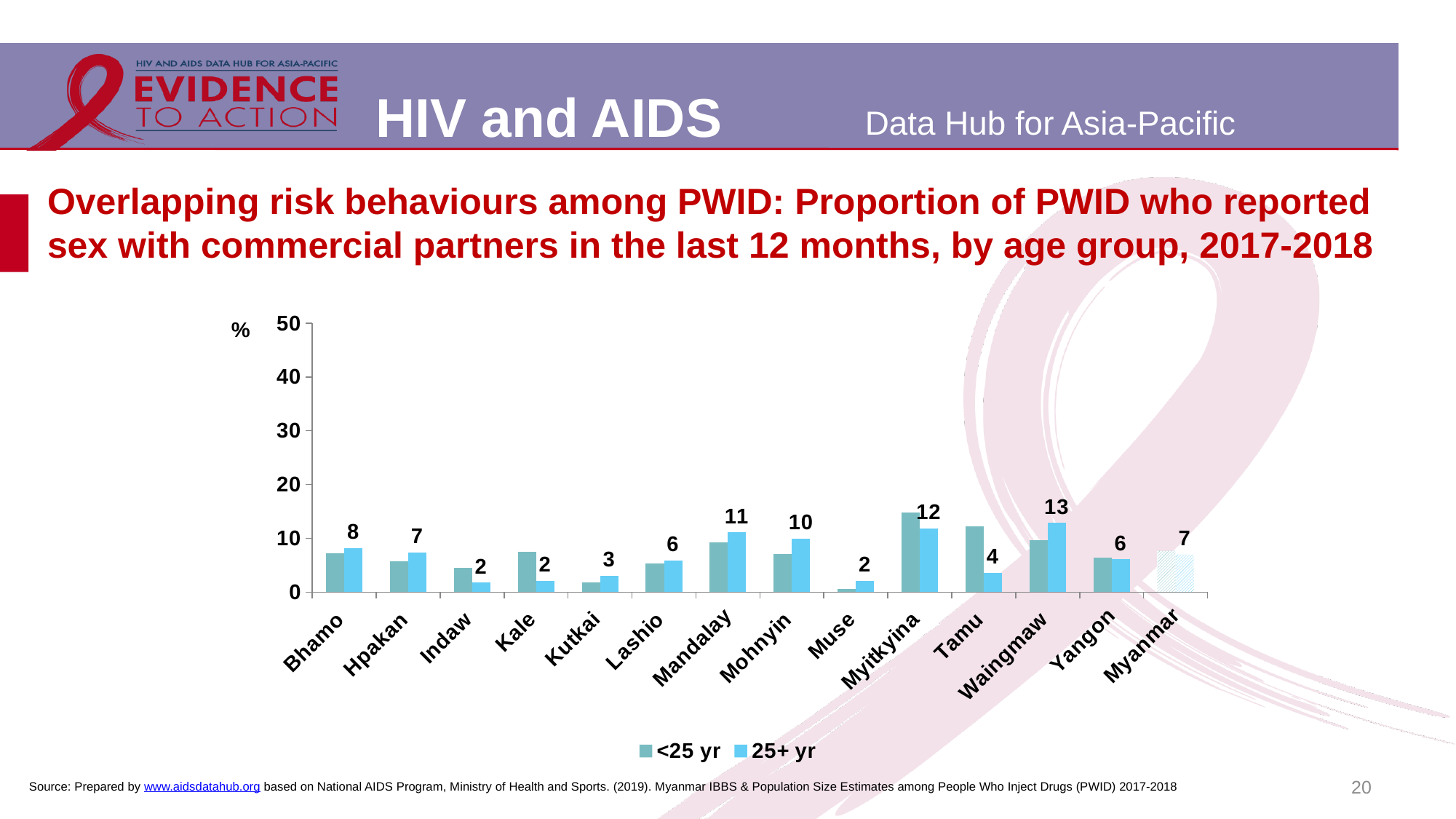
How many series does the legend list? 2 What is the difference between the 25+ yr values for Waingmaw and Tamu? 9 For the 25+ yr series, which is larger: Mandalay or Mohnyin? Mandalay What is the value for the 25+ yr series in Waingmaw? 13 Which location has the highest value for the 25+ yr series? Waingmaw What is the value for the 25+ yr series in Mandalay? 11 What kind of chart is shown on the slide? Bar chart Is the value for the <25 yr series in Myitkyina greater or less than 10? greater How many locations are shown on the x axis? 14 Is the value for the <25 yr series in Muse greater or less than 10? less What is the value for the 25+ yr series in Myitkyina? 12 What are the two series named in the legend? <25 yr and 25+ yr